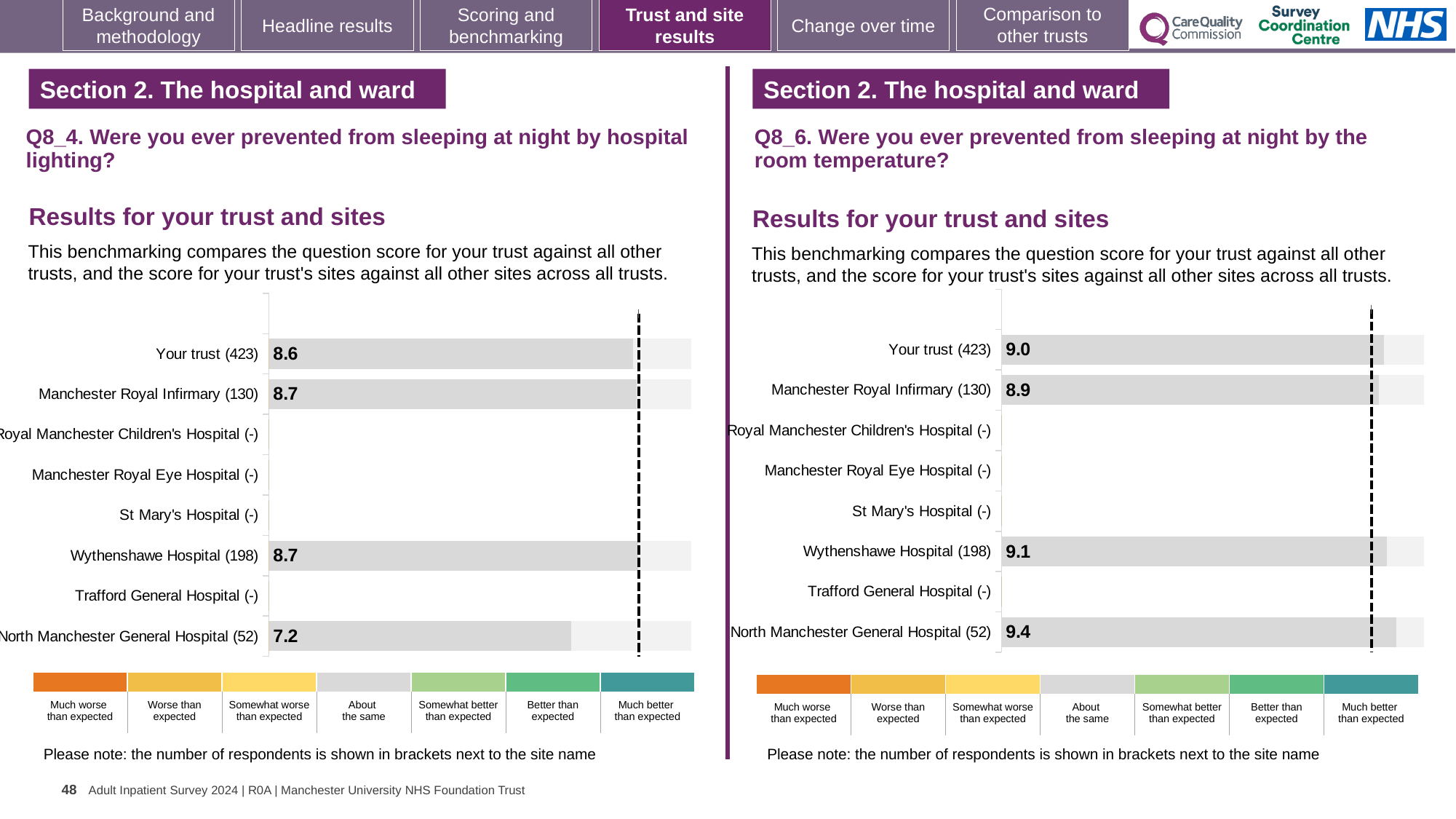
On the Q8_4 hospital lighting chart, which site has the lowest score? North Manchester General Hospital (52) How many site/trust categories are listed on the Q8_6 room temperature chart? 8 On the Q8_6 room temperature chart, what is the score for Manchester Royal Infirmary (130)? 8.9 On the Q8_4 hospital lighting chart, what is the difference between the scores for Wythenshawe Hospital (198) and North Manchester General Hospital (52)? 1.5 How many benchmark categories does the colour key below the Q8_4 chart show? 7 On the Q8_6 room temperature chart, which site has the highest score? North Manchester General Hospital (52) What kind of chart is used for the Q8_4 hospital lighting results? Bar chart On the Q8_6 room temperature chart, what is the difference between the scores for North Manchester General Hospital (52) and Your trust (423)? 0.4 On the Q8_4 hospital lighting chart, what is the score for North Manchester General Hospital (52)? 7.2 On the Q8_6 room temperature chart, what is the score for Wythenshawe Hospital (198)? 9.1 On the Q8_4 hospital lighting chart, which has the higher score: Your trust (423) or North Manchester General Hospital (52)? Your trust (423) On the Q8_4 hospital lighting chart, what is the score for Your trust (423)? 8.6